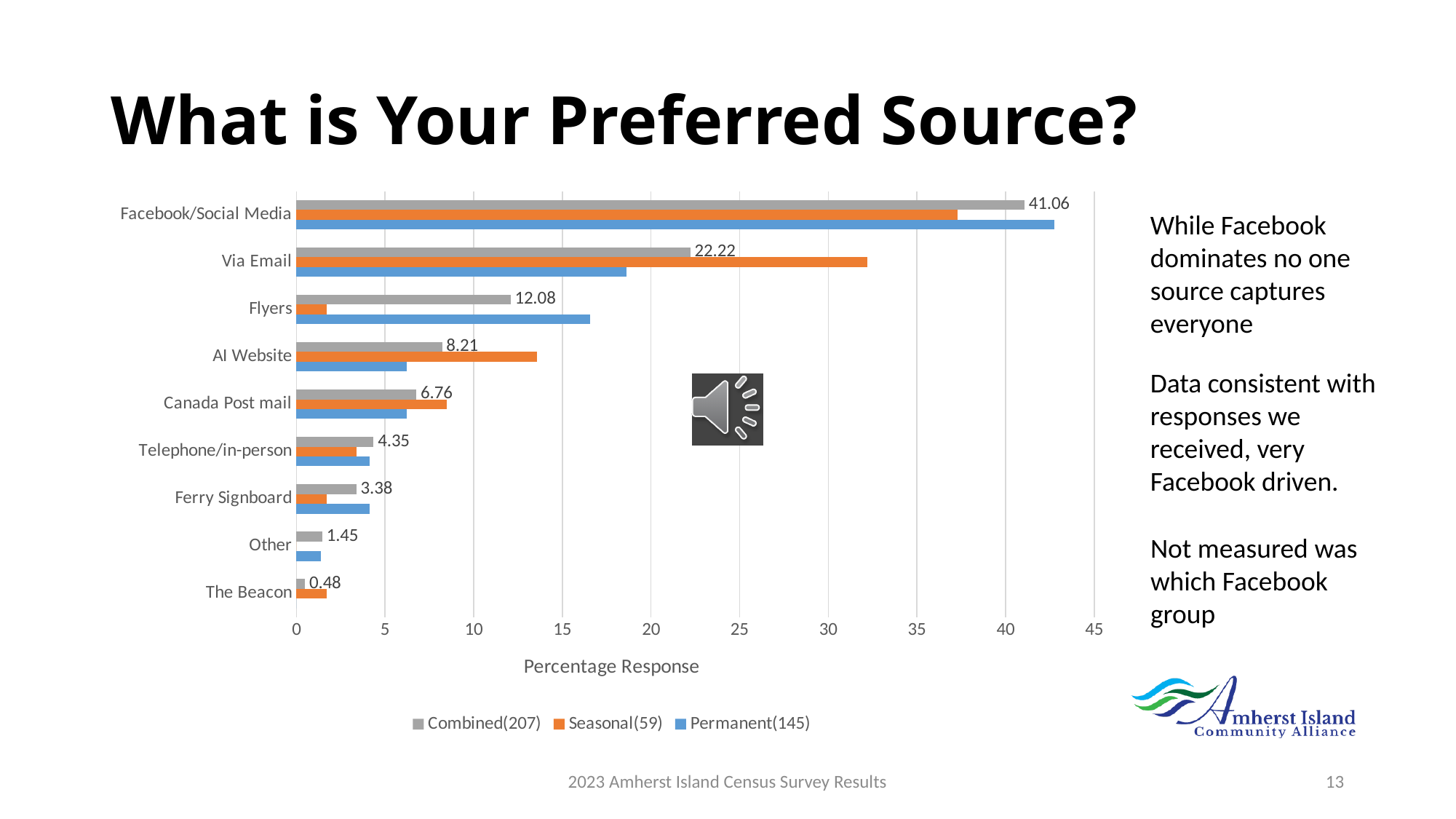
What is the Combined(207) value for Facebook/Social Media? 41.06 Is the Permanent(145) value for Facebook/Social Media greater or less than 40? greater How many series does the legend list? 3 What is the Combined(207) value for Via Email? 22.22 What is the Combined(207) value for Canada Post mail? 6.76 How many categories are shown on the chart? 9 Which is larger for Flyers: the Seasonal(59) value or the Permanent(145) value? Permanent(145) Which category has the lowest Combined(207) value? The Beacon Is the Seasonal(59) value for Via Email greater or less than 30? greater Which category has the highest Combined(207) value? Facebook/Social Media What is the difference between the Combined(207) values for Via Email and Flyers? 10.14 What kind of chart is shown on the slide? Bar chart